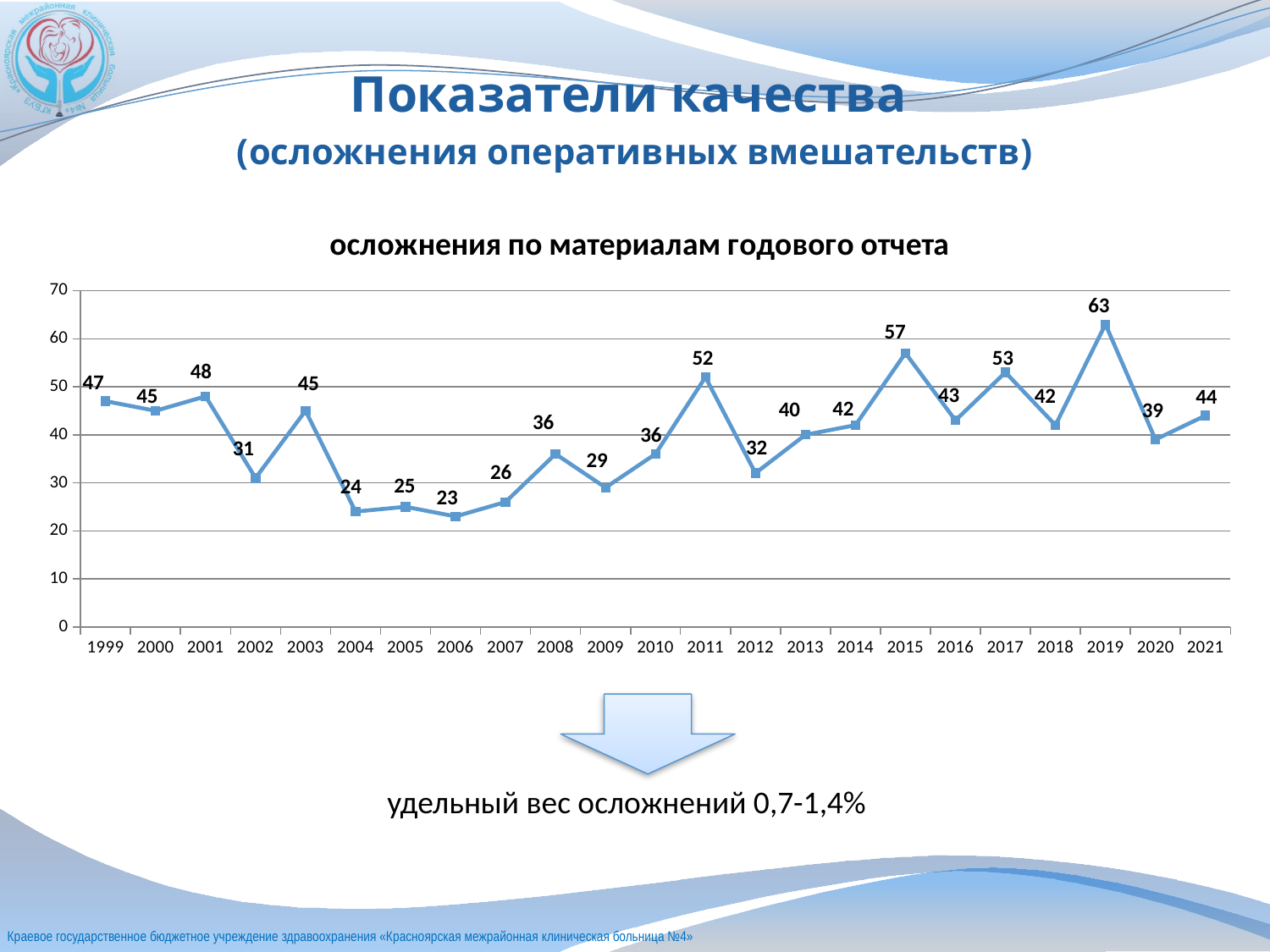
Which is larger, the value for 2015 or the value for 2017? 2015 How many years are plotted on the x axis? 23 Do the values rise or fall from 2003 to 2006? fall What is the title of the chart? осложнения по материалам годового отчета What is the value for 2019? 63 What is the value for 2006? 23 What is the value for 2021? 44 What kind of chart is shown? line chart Is the value for 2011 greater or less than 50? greater Which year has the highest value? 2019 Which year has the lowest value? 2006 What is the difference between the values for 2019 and 2020? 24